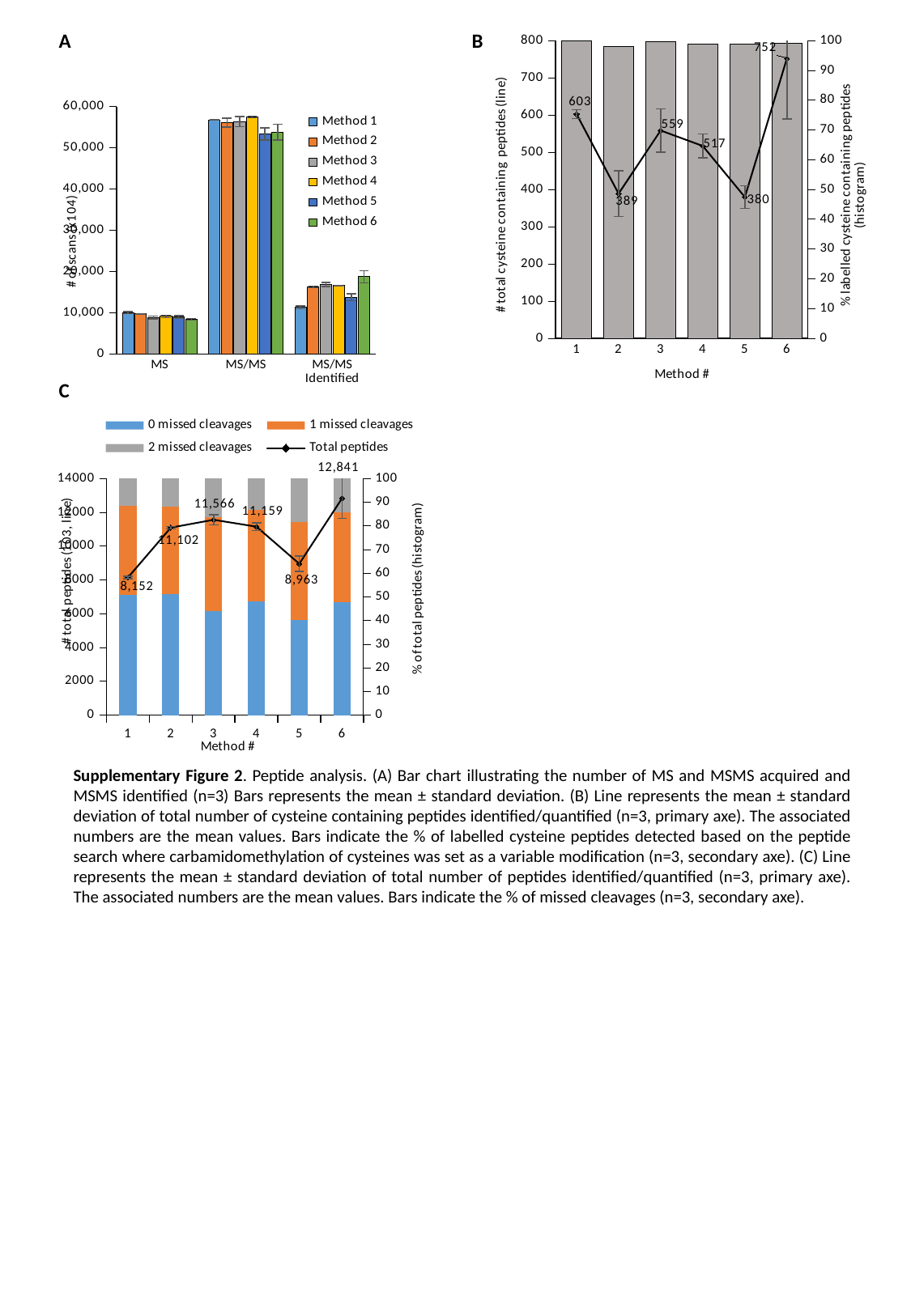
In chart B, what is the difference between the labelled line values for method 6 and method 5? 372 In chart C, what is the labelled total peptides value for method 3? 11,566 In chart C, which method has the lowest labelled total peptides value? 1 In chart C, what is the difference between the labelled total peptides values for method 6 and method 1? 4,689 In chart B, what is the labelled value of the line for method 1? 603 In chart A, how many series does the legend list? 6 In chart B, which method has the lowest labelled line value? 5 In chart B, which method has the highest labelled line value? 6 In chart A, how many categories are shown on the x axis? 3 In chart C, how many entries does the legend list? 4 In chart A, is the value for Method 1 in the MS/MS category greater or less than 50,000? greater In chart B, which has the larger labelled line value, method 3 or method 4? Method 3